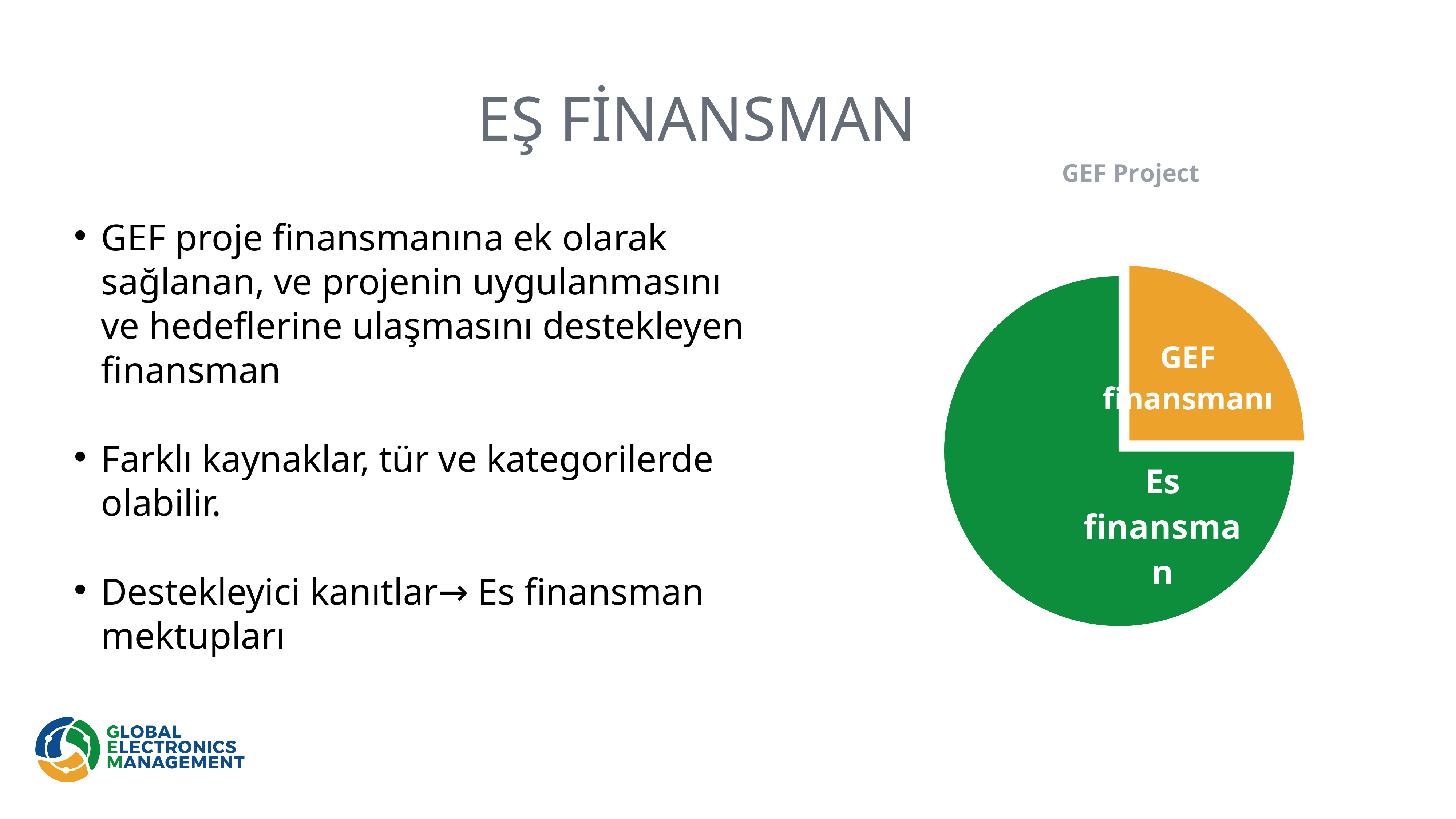
What is the title of the chart? GEF Project Which slice of the pie chart is the smallest? GEF finansmanı How many slices does the pie chart have? 2 Which slice is shown in orange? GEF finansmanı Which slice of the pie chart is the largest? Es finansman Which is larger in the pie chart, GEF finansmanı or Es finansman? Es finansman What kind of chart is shown on the slide? pie chart What colour is the Es finansman slice? green